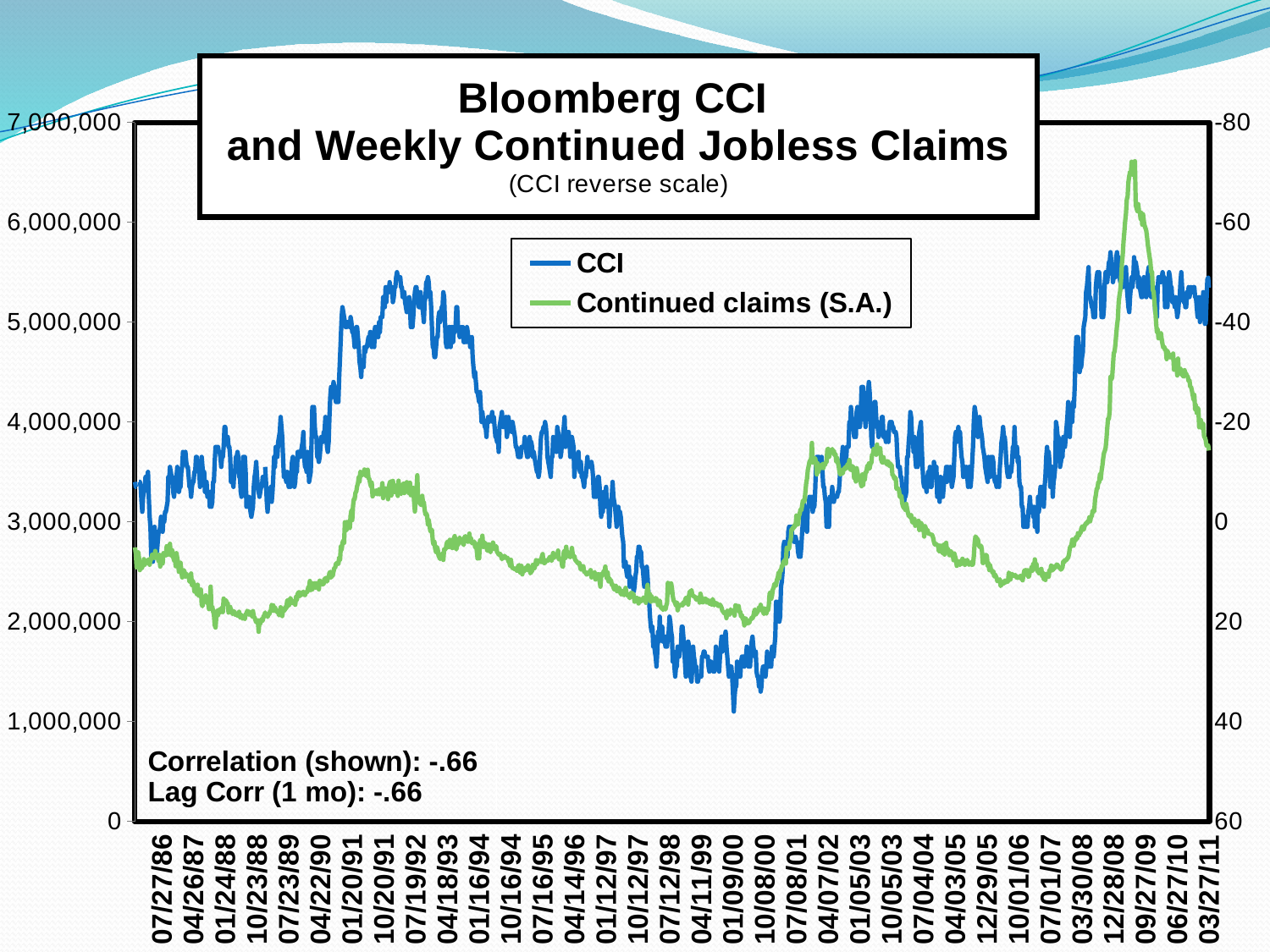
Does Continued claims (S.A.) rise or fall between 09/27/09 and 03/27/11? fall Is the value of Continued claims (S.A.) at 10/12/97 greater or less than 3,000,000? less Which is higher for Continued claims (S.A.): the value at 03/27/11 or the value at 07/27/86? 03/27/11 What correlation value is shown on the chart? -.66 What are the two series named in the legend? CCI and Continued claims (S.A.) In which year does Continued claims (S.A.) reach its highest value? 2009 Is the peak value of Continued claims (S.A.) around 2009 greater or less than 6,000,000? greater How many series does the legend list? 2 Does Continued claims (S.A.) rise or fall between 07/12/98 and 07/08/01? rise Is the value of Continued claims (S.A.) at 03/27/11 greater or less than 3,000,000? greater What kind of chart is shown on the slide? line chart